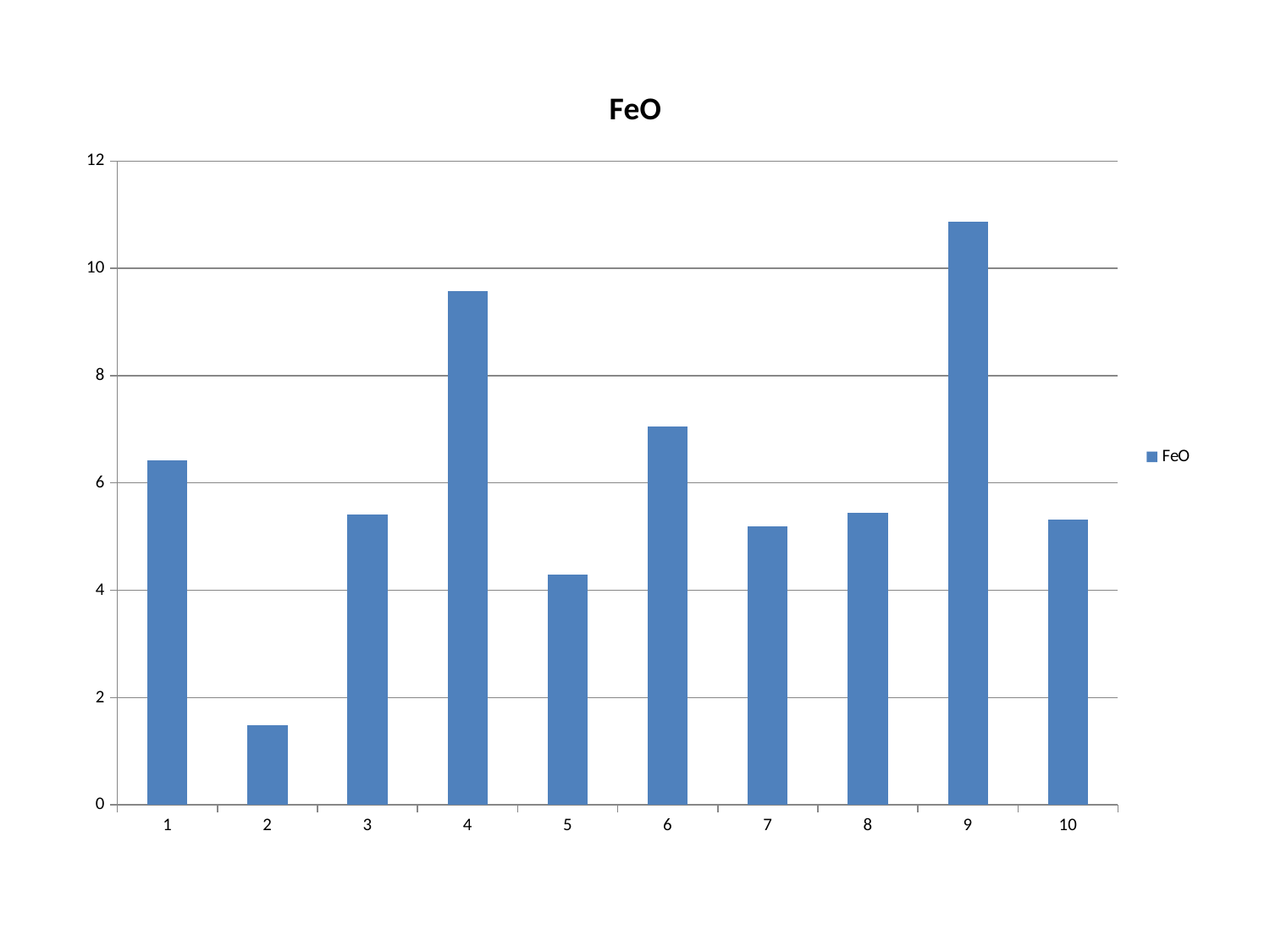
Is the value for category 4 greater or less than 8? greater Is the value for category 2 greater or less than 2? less How many series does the legend list? 1 What is the title of the chart? FeO Which category has the highest FeO value? 9 Which is larger, the value for category 1 or the value for category 5? 1 How many categories are shown on the x axis? 10 Is the value for category 5 greater or less than 6? less Which is larger, the value for category 4 or the value for category 6? 4 Which category has the lowest FeO value? 2 What type of chart is shown on the slide? bar chart